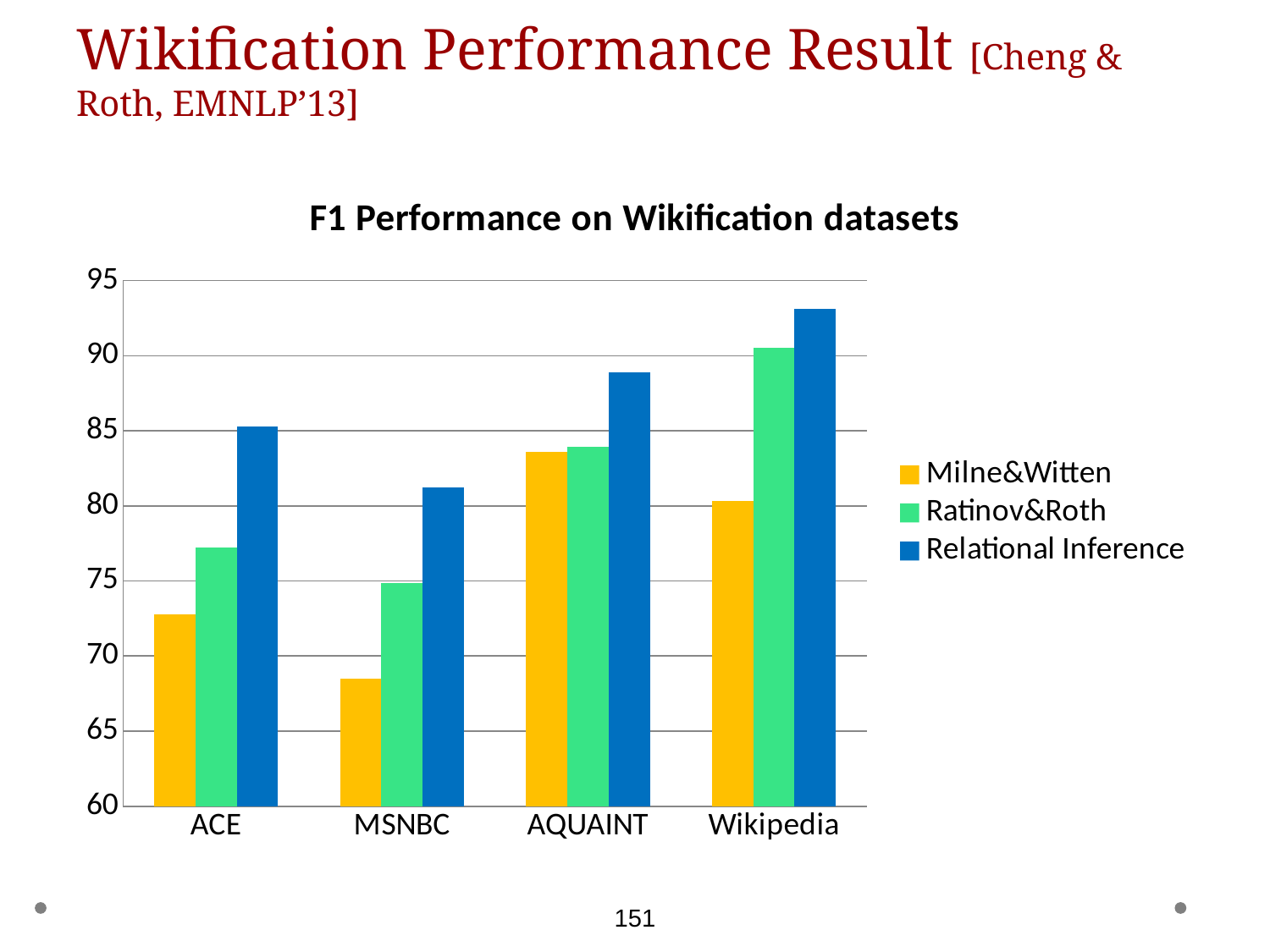
Which dataset has the highest Relational Inference bar? Wikipedia What is the title of the chart? F1 Performance on Wikification datasets Which series is shown in blue in the legend? Relational Inference How many datasets are shown on the x axis? 4 Is the Milne&Witten value for MSNBC greater or less than 70? less How many series does the legend list? 3 What type of chart is shown on the slide? bar chart Which dataset has the lowest Milne&Witten bar? MSNBC Which is larger: the Milne&Witten value for AQUAINT or the Milne&Witten value for Wikipedia? AQUAINT Which is larger for MSNBC: the Ratinov&Roth value or the Relational Inference value? Relational Inference Is the Ratinov&Roth value for Wikipedia greater or less than 90? greater